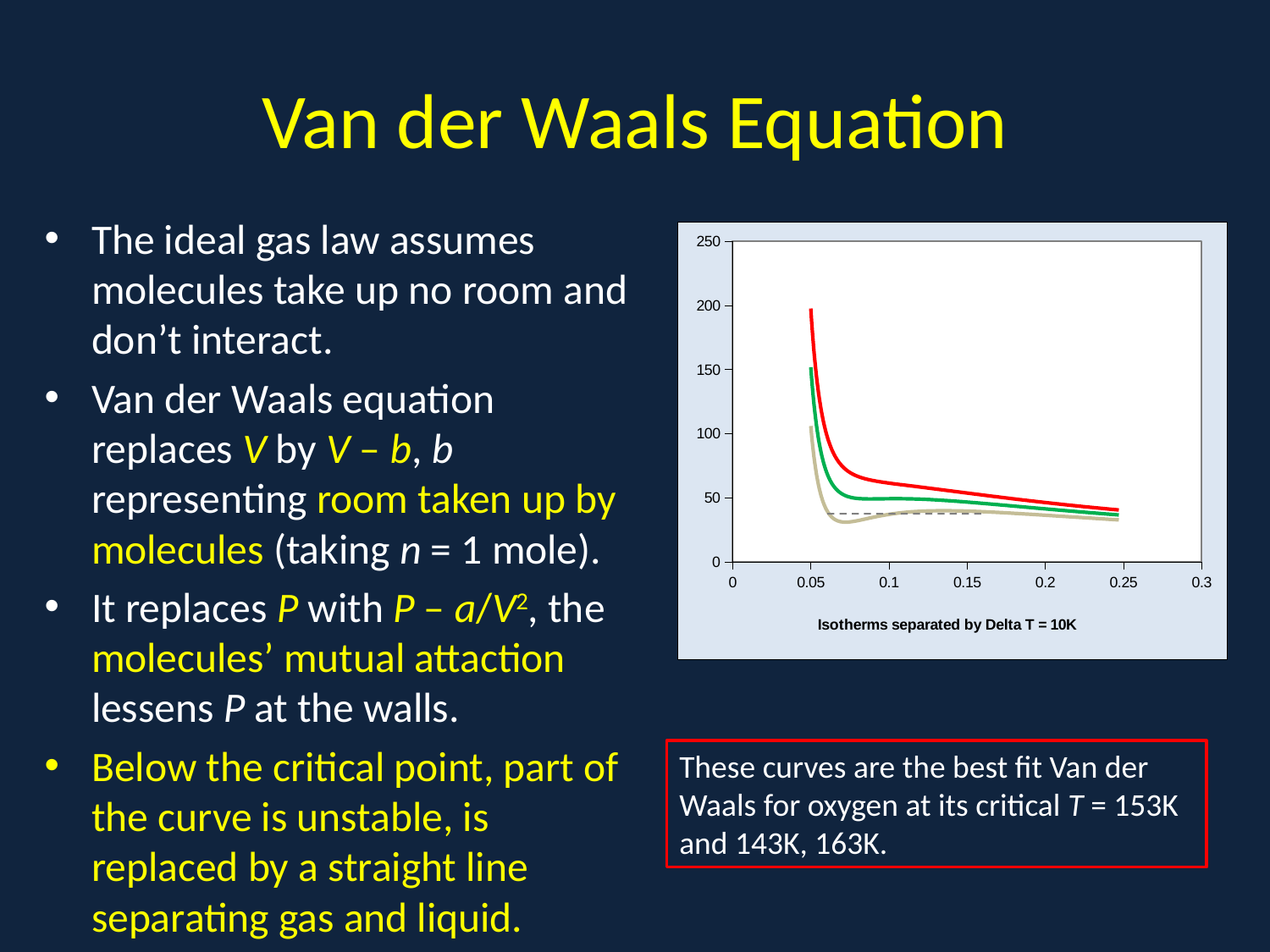
Is the value of the red curve at x = 0.2 greater or less than 100? less Is the value of the green curve at x = 0.1 greater or less than 100? less What is the highest value labelled on the y-axis? 250 Is the starting value of the red curve near x = 0.05 greater or less than 150? greater What kind of chart is shown on the slide? line chart Do the curves rise or fall as the x-axis value increases? fall How many solid coloured curves are plotted on the chart? 3 Which coloured curve lies highest on the chart? red Which coloured curve lies lowest on the chart? tan What is the title printed below the chart? Isotherms separated by Delta T = 10K Which curve is higher at x = 0.15, the red curve or the green curve? red